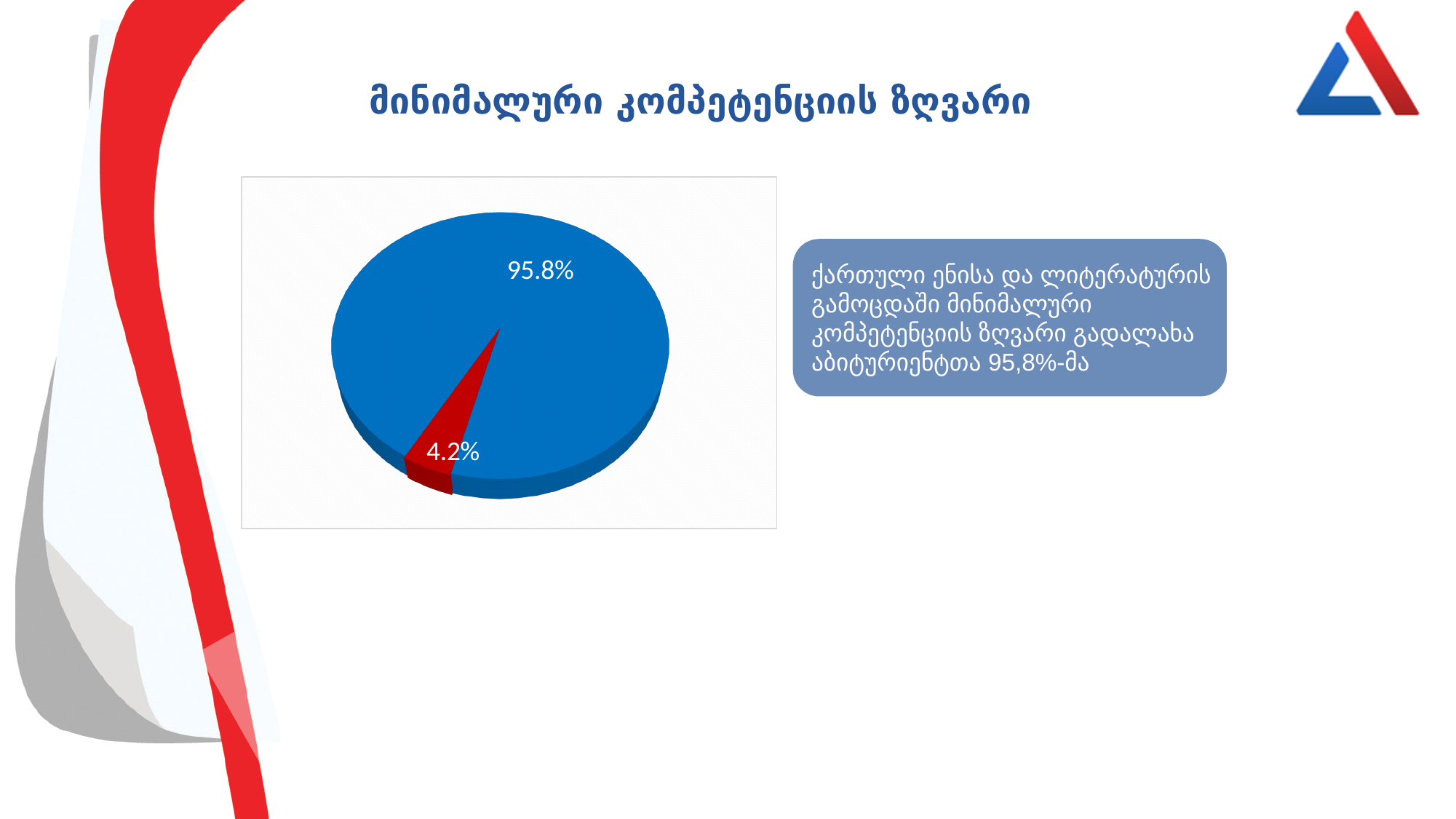
How many slices does the pie chart have? 2 Which slice of the pie chart is the largest? the blue slice (95.8%) What share of the pie does the red slice represent? 4.2% What kind of chart is shown on the slide? pie chart Is the value of the red slice greater or less than 10%? less Which is larger, the blue slice or the red slice? the blue slice Is the value of the blue slice greater or less than 90%? greater What is the total of the two slice values shown on the pie chart? 100% What share of the pie does the blue slice represent? 95.8% Which slice of the pie chart is the smallest? the red slice (4.2%) What colour is the slice labelled 4.2%? red What is the difference in percentage points between the blue slice and the red slice? 91.6